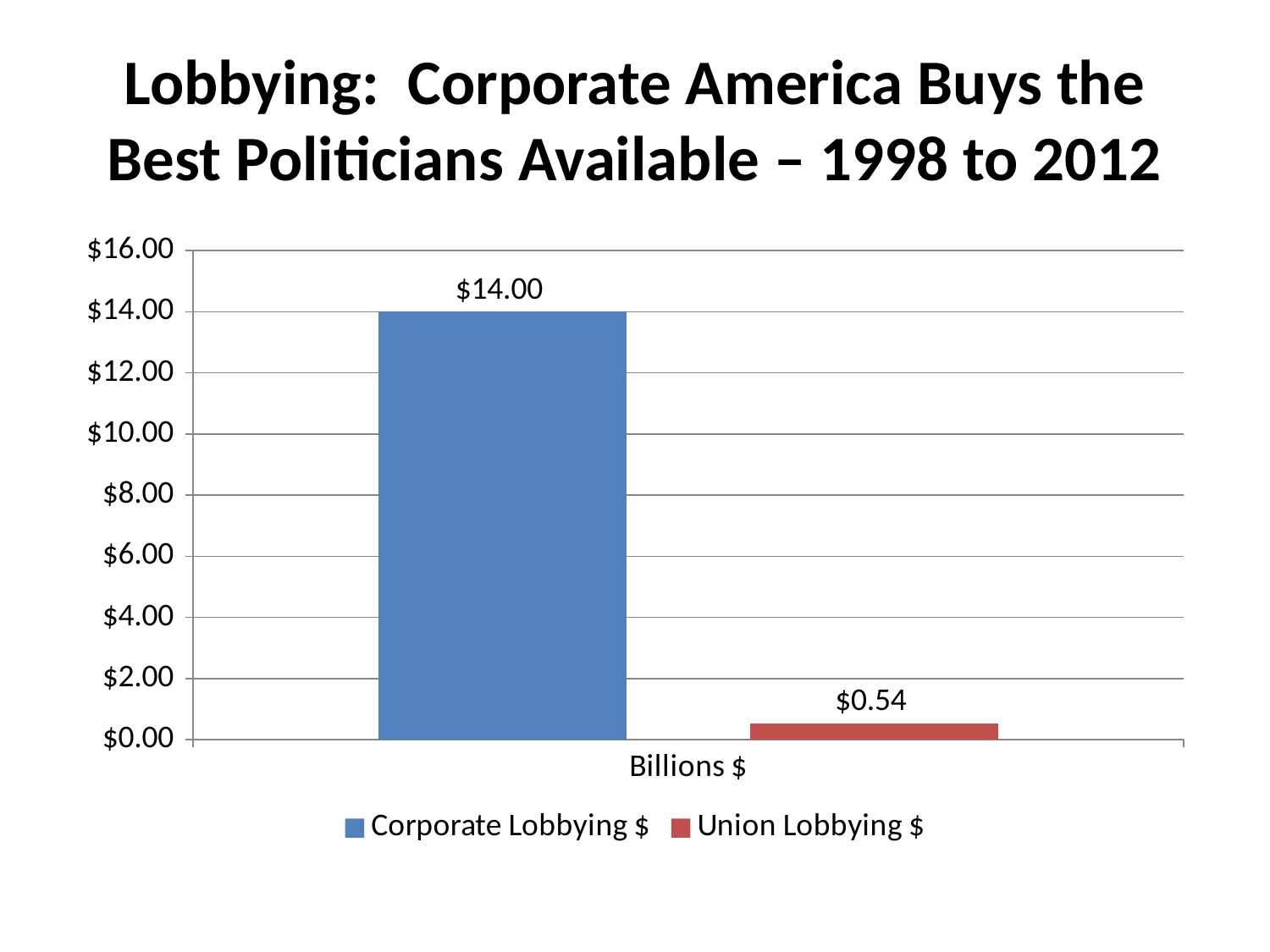
Is the value for Union Lobbying $ greater or less than $2.00? less Which series has the higher value, Corporate Lobbying $ or Union Lobbying $? Corporate Lobbying $ What kind of chart is shown on the slide? bar chart Which series has the lowest value? Union Lobbying $ What is the value for Corporate Lobbying $? $14.00 What is the value for Union Lobbying $? $0.54 What colour is the bar for Union Lobbying $? red What is the difference between the Corporate Lobbying $ value and the Union Lobbying $ value? $13.46 What is the label on the x axis of the chart? Billions $ How many series does the legend list? 2 Is the value for Corporate Lobbying $ greater or less than $12.00? greater What is the highest value shown on the y axis? $16.00